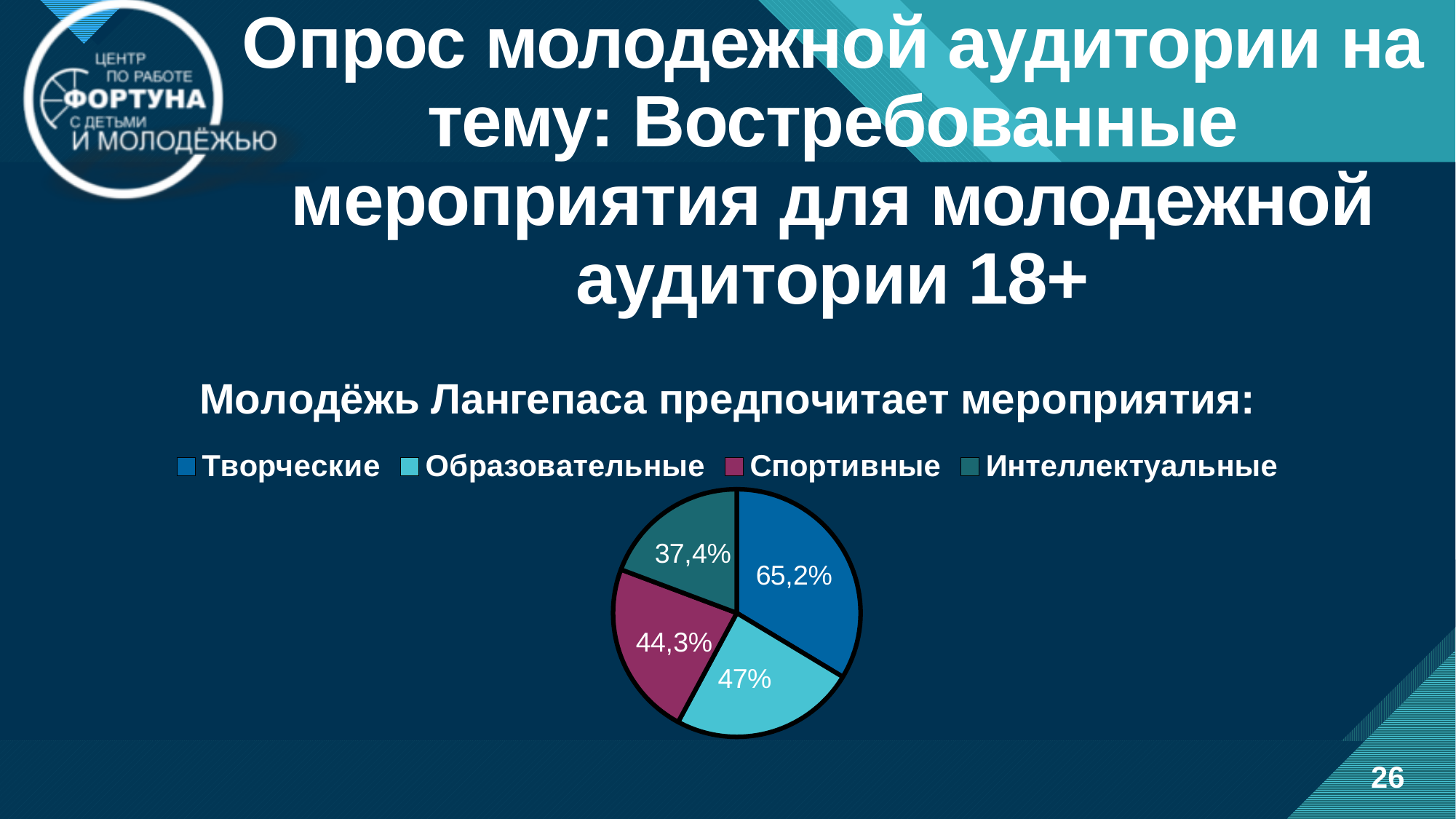
Which category has the lowest value in the pie chart? Интеллектуальные Which category has the highest value in the pie chart? Творческие What is the difference between the values for Образовательные and Спортивные? 2,7% What is the value shown for Спортивные? 44,3% How many categories does the pie chart have? 4 What kind of chart is shown on the slide? Pie chart Which is larger, the value for Спортивные or the value for Интеллектуальные? Спортивные What is the difference between the values for Творческие and Интеллектуальные? 27,8% What is the value shown for Интеллектуальные? 37,4% What is the title of the chart? Молодёжь Лангепаса предпочитает мероприятия: What is the value shown for Образовательные? 47% What is the value shown for Творческие? 65,2%